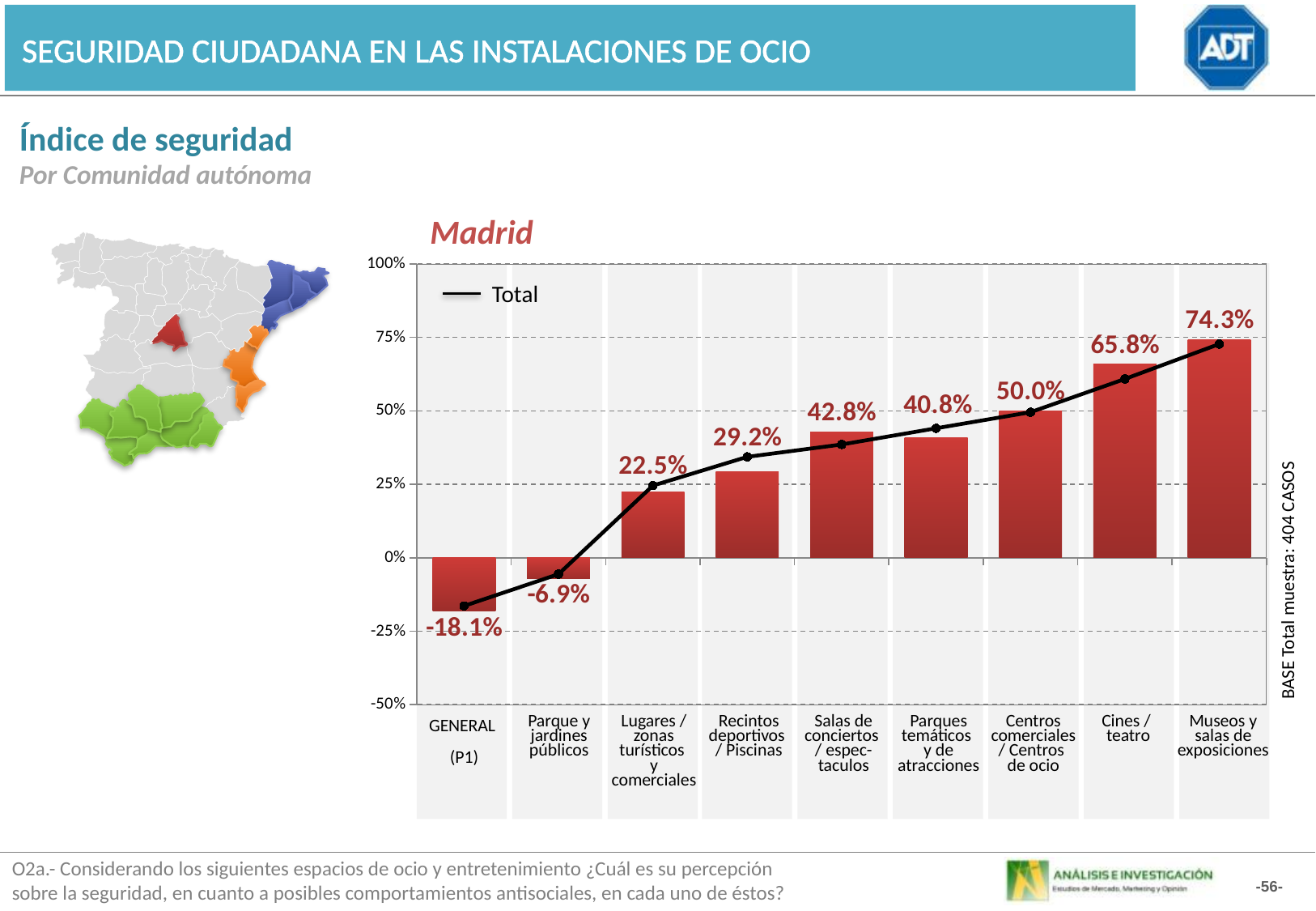
Is the Total line value for Cines / teatro greater or less than 50%? greater What kind of chart is used for the Madrid values? bar chart What is the Madrid value for Cines / teatro? 65.8% Which category has the highest Madrid value? Museos y salas de exposiciones What is the Madrid value for Parques temáticos y de atracciones? 40.8% Which category has the lowest Madrid value? GENERAL (P1) Do the Madrid bar values generally rise or fall from left to right? rise What is the Madrid value for GENERAL (P1)? -18.1% How many categories are shown on the x axis? 9 What is the difference between the Madrid values for Museos y salas de exposiciones and Cines / teatro? 8.5% How many series does the legend list? 1 Which has a larger Madrid value, Salas de conciertos / espectáculos or Parques temáticos y de atracciones? Salas de conciertos / espectáculos